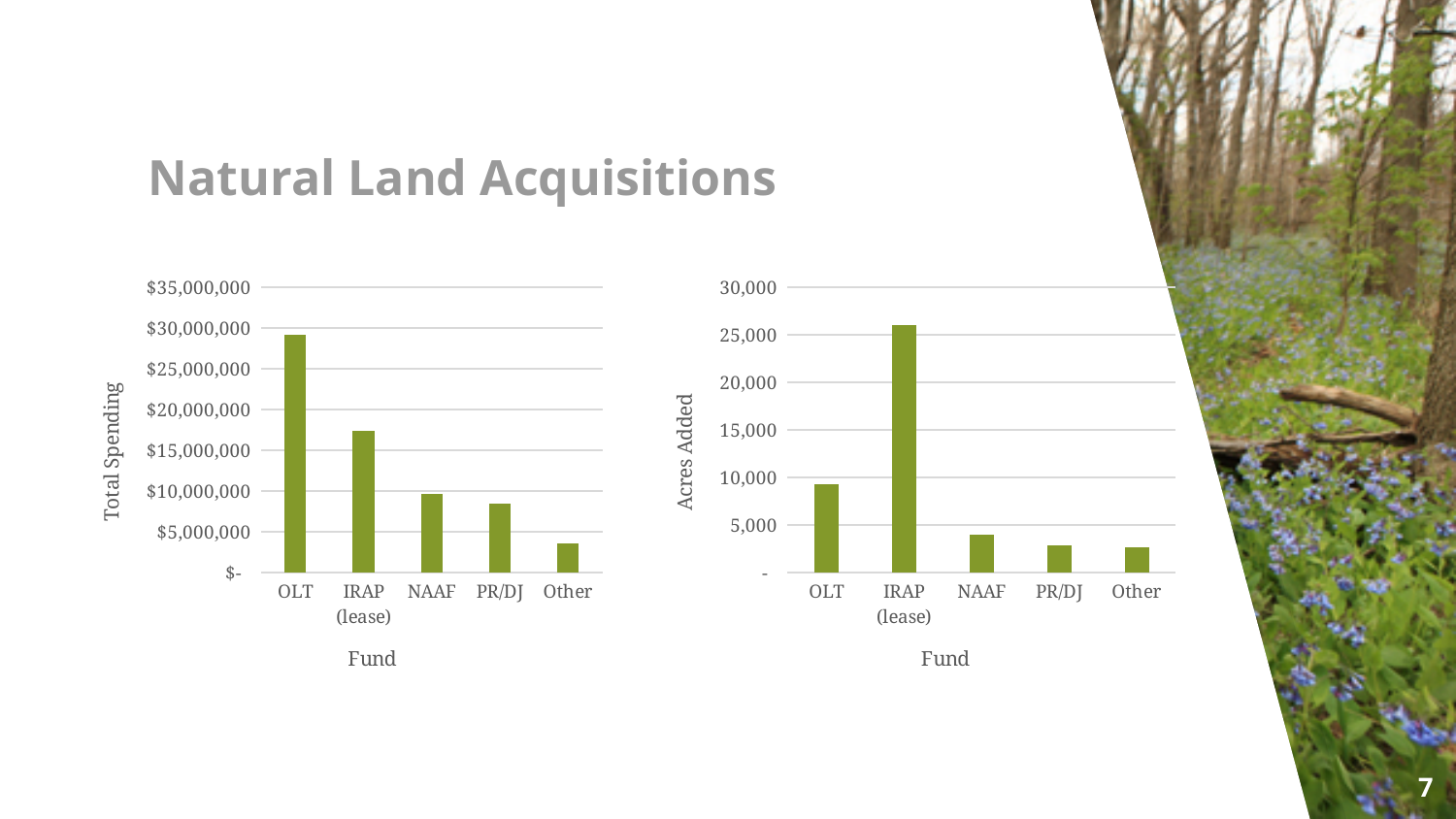
In the left chart (Total Spending), is the value for Other greater or less than $5,000,000? less In the right chart (Acres Added), is the value for IRAP (lease) greater or less than 25,000? greater In the right chart (Acres Added), which fund added the most acres? IRAP (lease) In the left chart (Total Spending), which fund has the lowest total spending? Other In the left chart (Total Spending), which fund has the highest total spending? OLT In the left chart (Total Spending), is the value for IRAP (lease) greater or less than $20,000,000? less In the left chart (Total Spending), which is larger, the value for IRAP (lease) or the value for NAAF? IRAP (lease) How many funds are shown on the x axis of the right chart (Acres Added)? 5 What kind of chart is the left chart (Total Spending)? Bar chart In the right chart (Acres Added), which is larger, the value for OLT or the value for NAAF? OLT